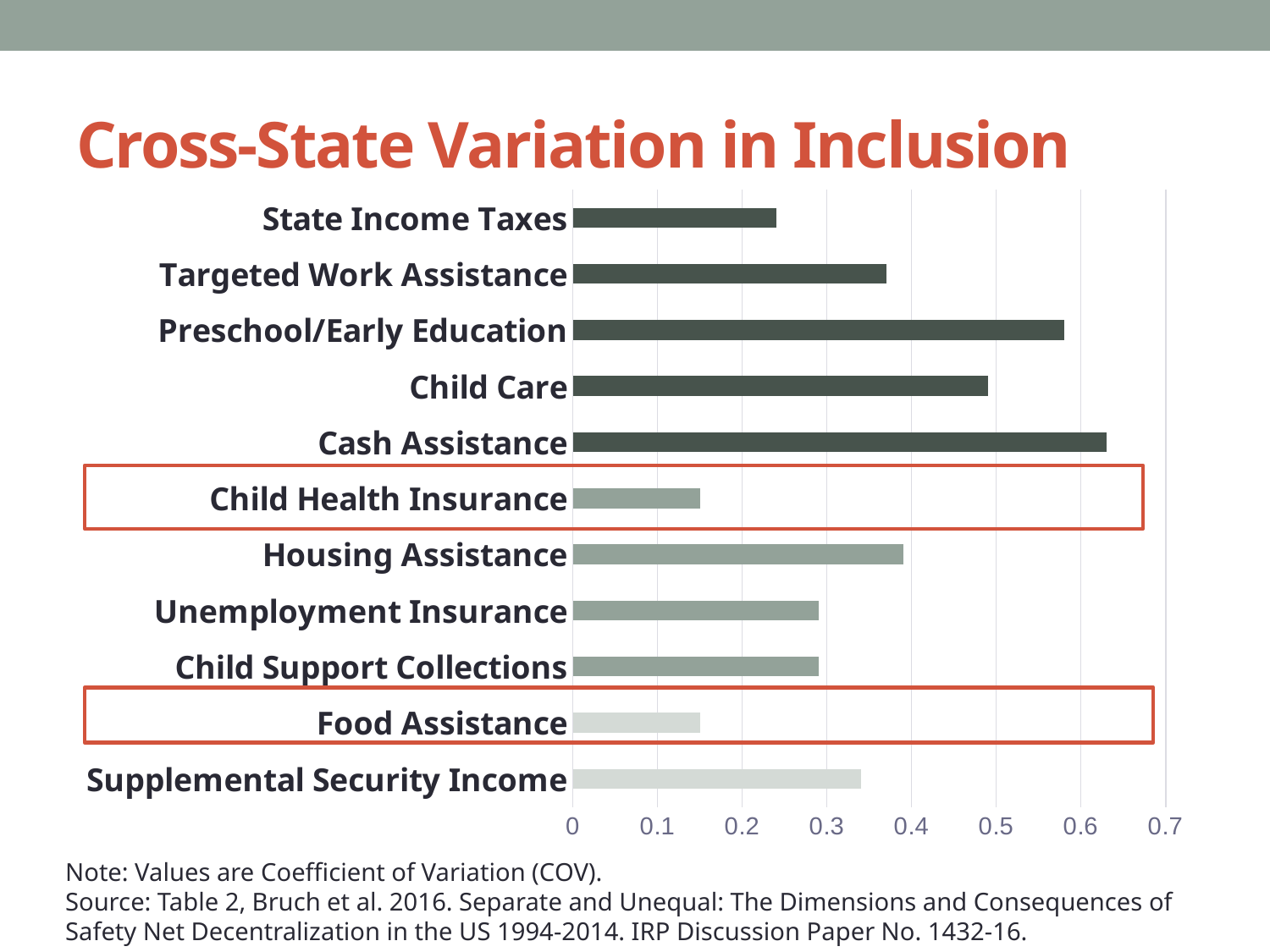
How many categories are plotted in the chart? 11 Is the value for State Income Taxes greater or less than 0.3? less Which has a larger value, Child Care or Housing Assistance? Child Care Is the value for Food Assistance greater or less than 0.2? less Which two categories are highlighted with red boxes on the chart? Child Health Insurance and Food Assistance What kind of chart is shown on the slide? bar chart Which category has the highest value in the chart? Cash Assistance What is the title of the chart on the slide? Cross-State Variation in Inclusion Which has a larger value, Preschool/Early Education or Child Care? Preschool/Early Education Is the value for Preschool/Early Education greater or less than 0.5? greater